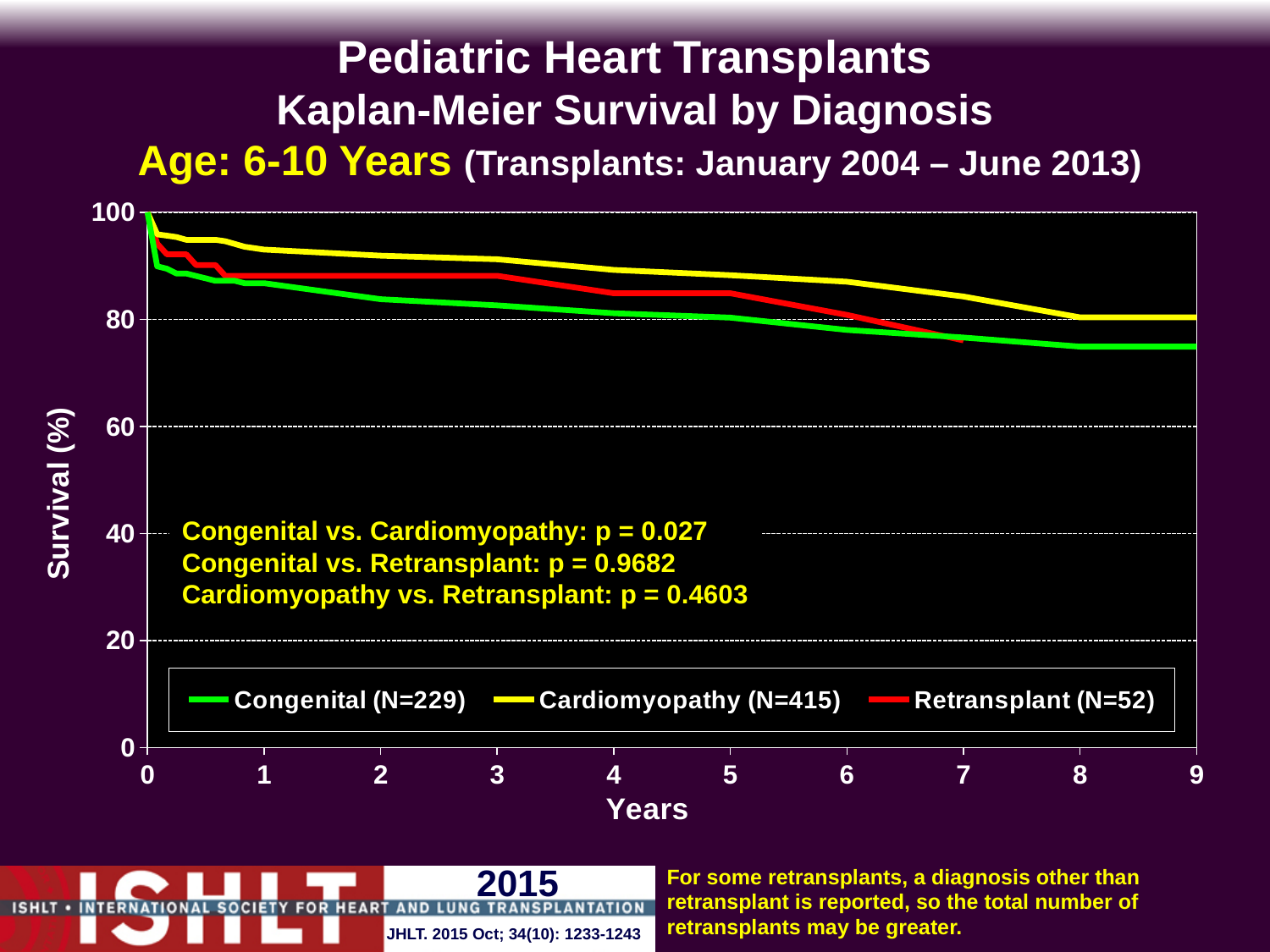
Is the survival for Cardiomyopathy at year 4 greater or less than 80? greater Do the survival curves rise or fall as years increase? fall Is the survival for Cardiomyopathy at year 1 greater or less than 80? greater Is the survival for Congenital at year 8 greater or less than 80? less What is the N for the Retransplant group shown in the legend? 52 Which diagnosis group has the highest survival at year 5? Cardiomyopathy (N=415) Which diagnosis group has the lowest survival at year 3? Congenital (N=229) What kind of chart is shown on the slide? line chart At year 7, which is larger: the survival for Cardiomyopathy or for Congenital? Cardiomyopathy What p-value is shown for Congenital vs. Cardiomyopathy? 0.027 How many series does the legend list? 3